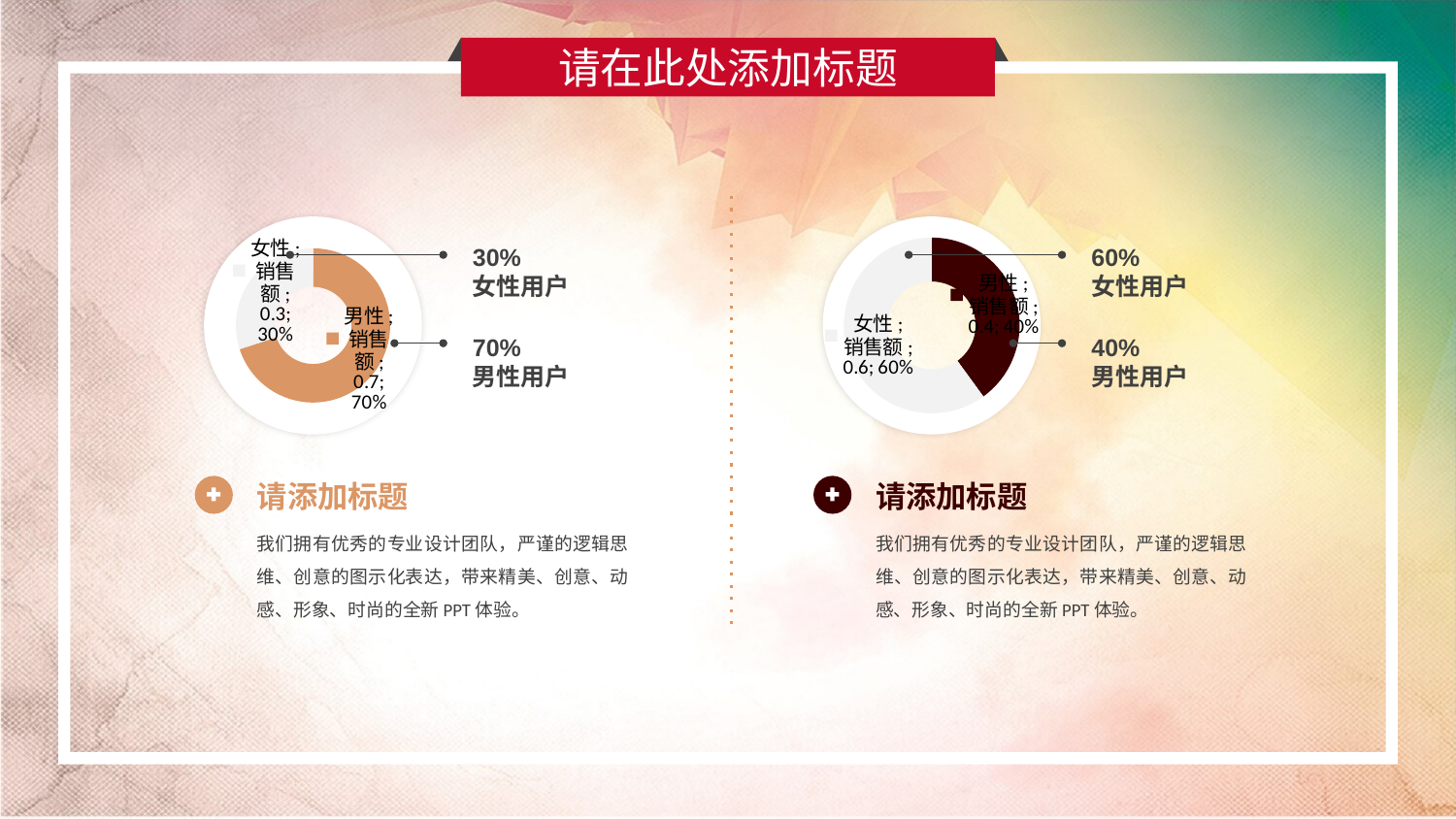
In the right chart, which category has the smaller share? 男性销售额 How many slices does the right chart have? 2 In the right chart, what percentage is shown for 女性销售额? 60% In the left chart, what percentage is shown for 男性销售额? 70% In the right chart, what percentage is shown for 男性销售额? 40% In the right chart, what is the difference in percentage points between 女性销售额 and 男性销售额? 20 percentage points What kind of chart is the left chart on the slide? Doughnut chart What colour is the 男性销售额 slice in the left chart? Orange In the left chart, what percentage is shown for 女性销售额? 30% In the left chart, what is the difference in percentage points between 男性销售额 and 女性销售额? 40 percentage points In the left chart, which category has the larger share? 男性销售额 In the right chart, is the share for 女性销售额 larger or smaller than the share for 男性销售额? Larger